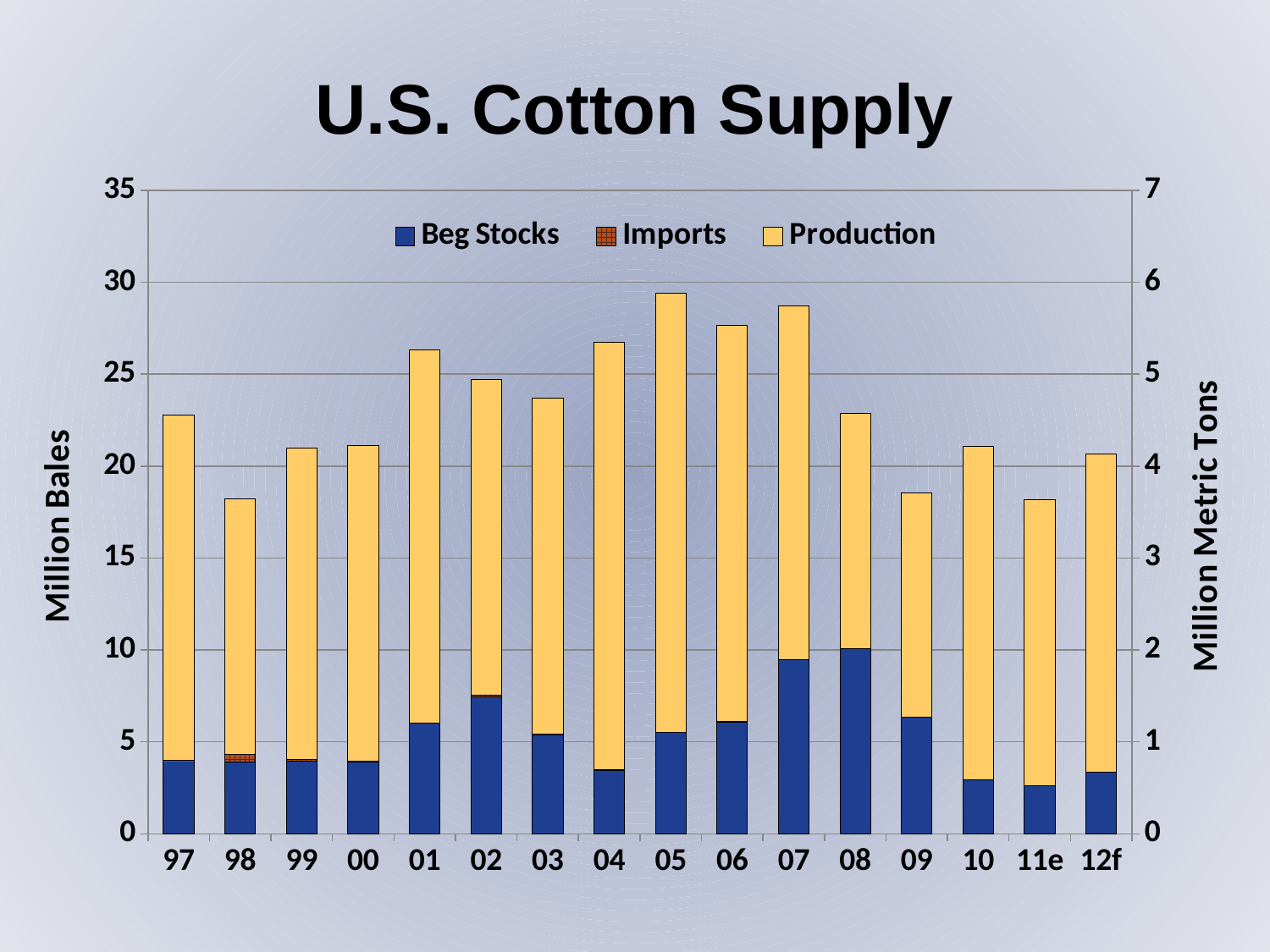
Which year has the larger Beg Stocks segment, 01 or 02? 02 Which year has the highest total supply bar? 05 Is the total supply for 05 greater or less than 25 million bales? greater Which year has the tallest Beg Stocks segment? 08 How many series does the legend list? 3 Do the Beg Stocks values rise or fall from 08 to 11e? fall Is the Beg Stocks value for 07 greater or less than 5 million bales? greater What is the label on the right-hand vertical axis? Million Metric Tons How many years (categories) are shown on the x axis? 16 What kind of chart is shown on the slide? Stacked bar chart Is the total supply for 98 greater or less than 20 million bales? less Which year has the larger total supply bar, 05 or 06? 05